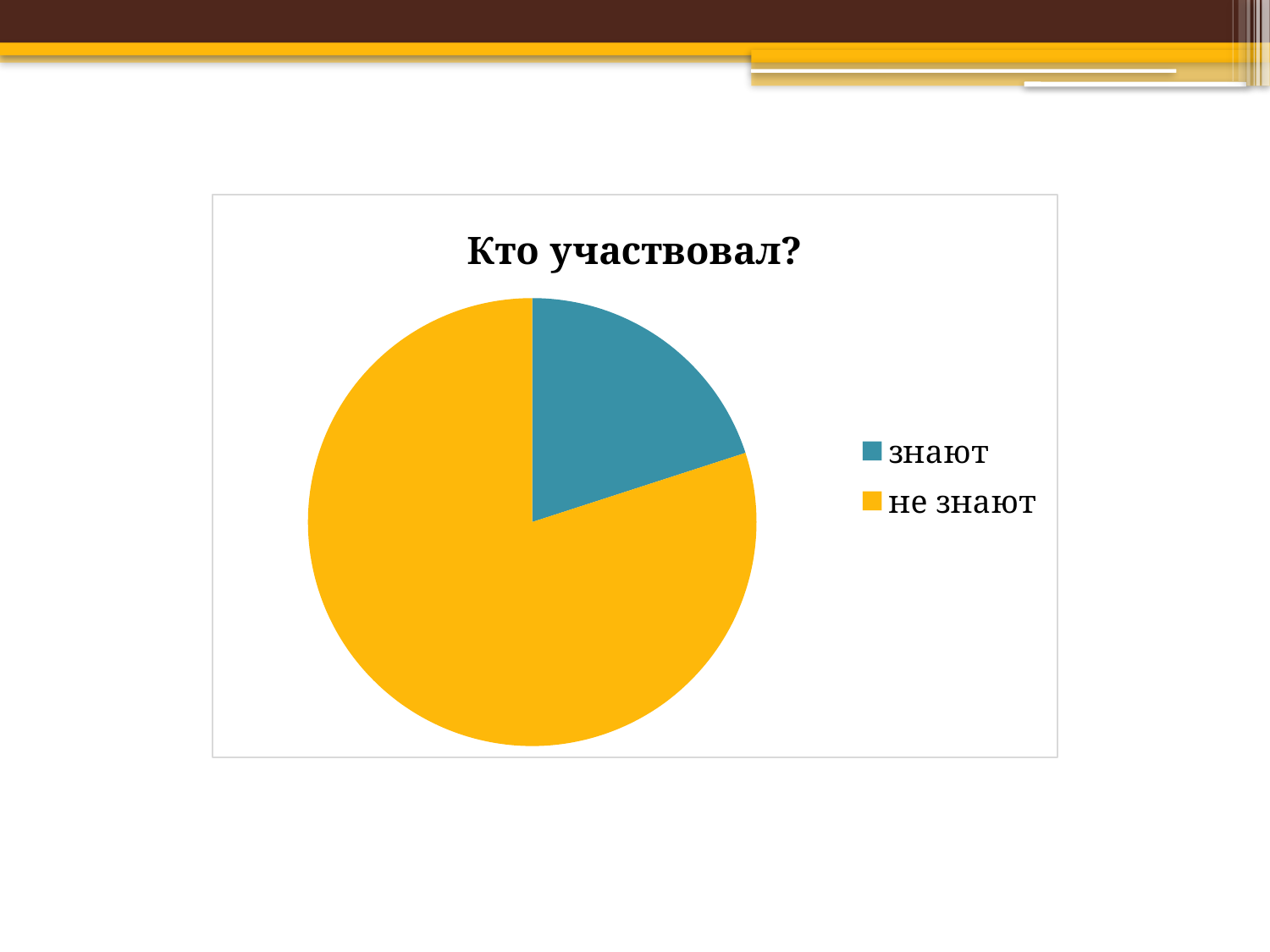
Which category has the largest slice of the pie? не знают What is the title of the chart? Кто участвовал? Which category has the smallest slice of the pie? знают What colour is the slice for "не знают"? yellow How many entries does the legend list? 2 How many slices does the pie chart have? 2 Which slice is larger, "знают" or "не знают"? не знают What kind of chart is shown on the slide? pie chart